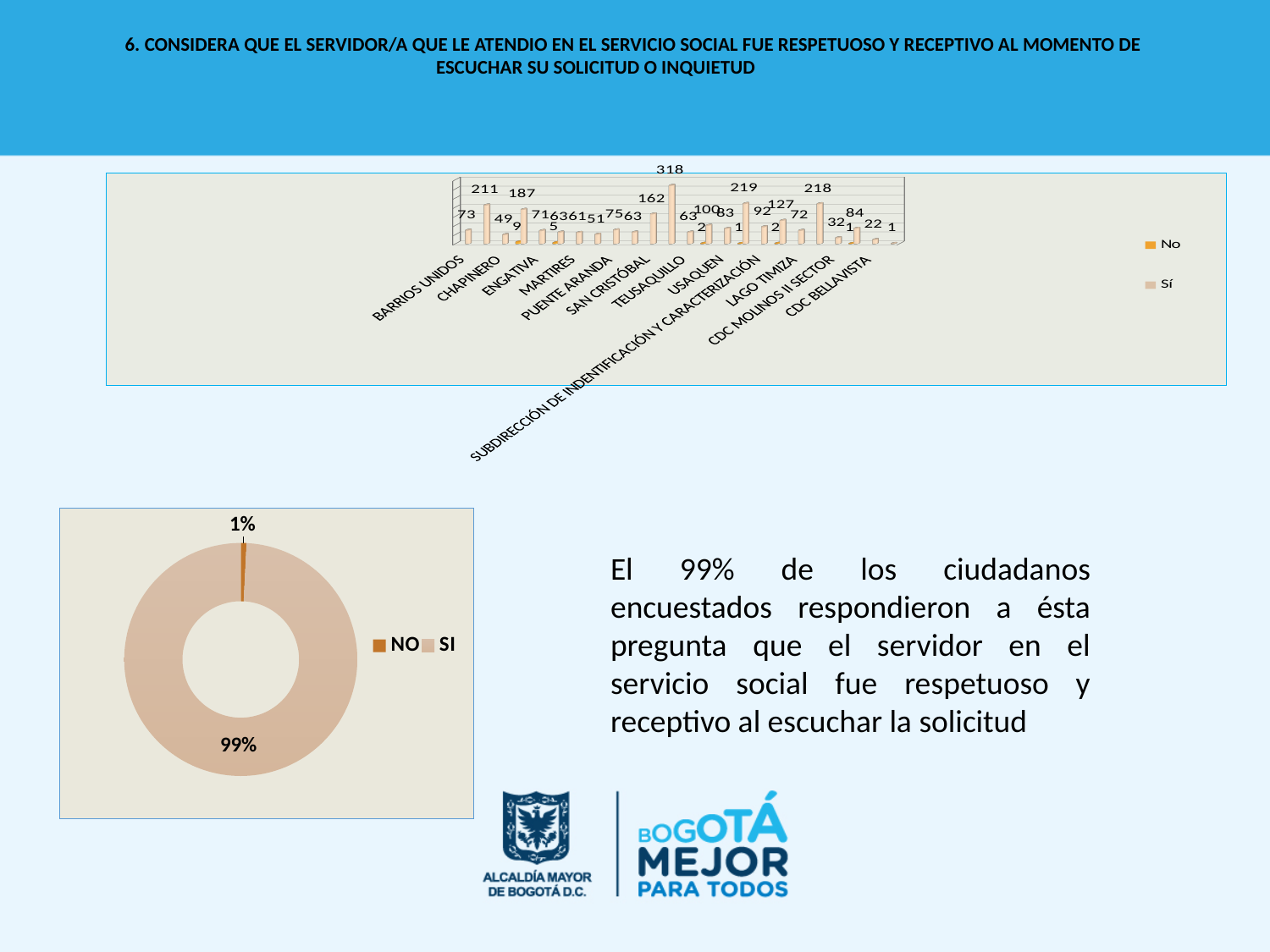
What kind of chart is shown at the bottom left of the slide? Doughnut (pie) chart What kind of chart is shown at the top of the slide? Bar chart What are the legend entries of the bottom-left doughnut chart? NO and SI In the doughnut chart at the bottom left, what is the difference in percentage points between the SI and NO shares? 98% In the top bar chart, what is the highest data label shown? 318 In the doughnut chart at the bottom left, what percentage of respondents answered SI? 99% In the top bar chart, what is the lowest data label shown? 1 How many entries does the legend of the bottom-left doughnut chart list? 2 How many series does the legend of the top bar chart list? 2 What are the legend entries of the top bar chart? No and Sí In the doughnut chart at the bottom left, which response has the larger share, NO or SI? SI In the doughnut chart at the bottom left, what percentage of respondents answered NO? 1%